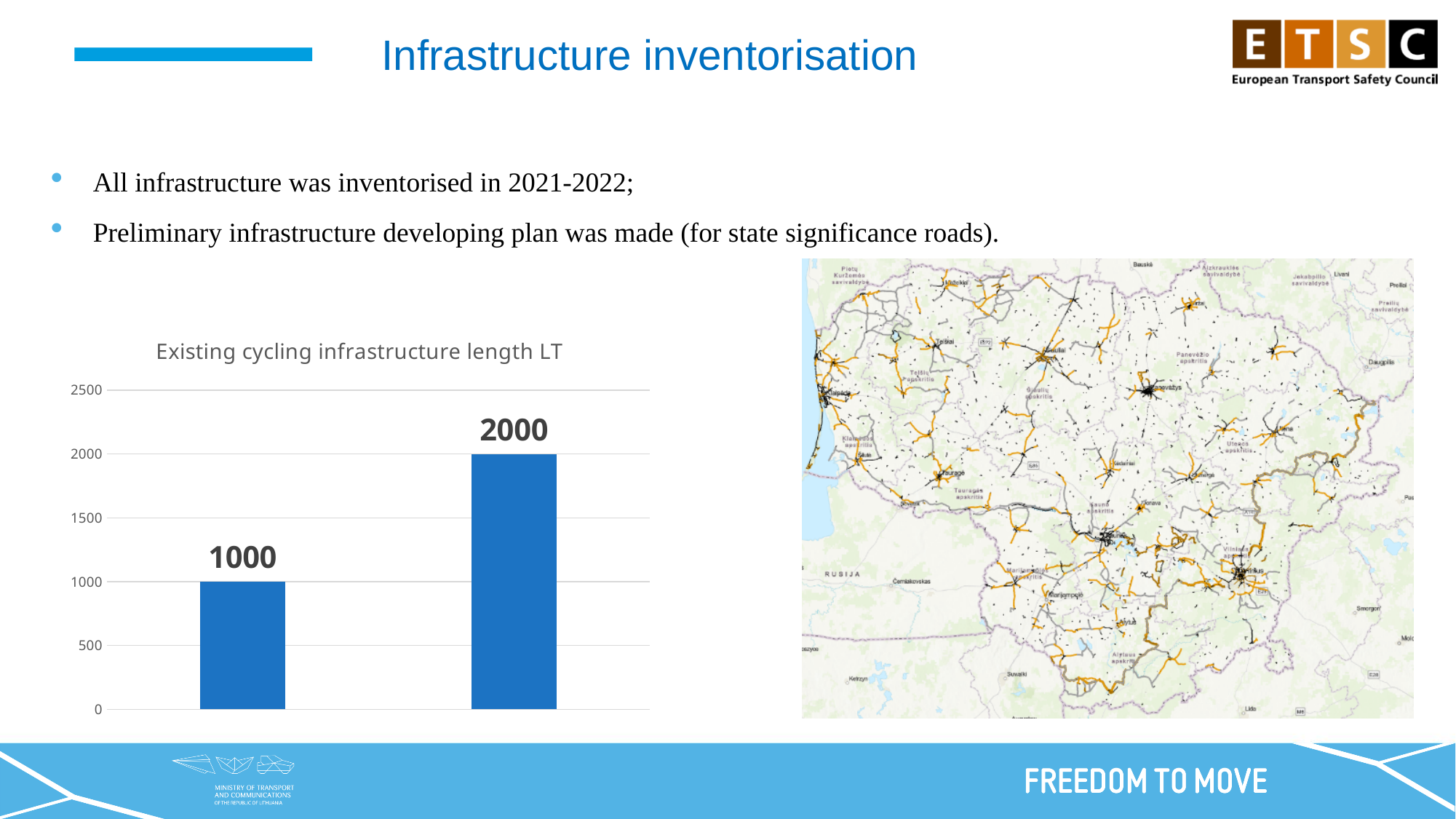
Do the bar values rise or fall from left to right? rise What is the highest value shown on the vertical axis of the chart? 2500 What is the difference between the right bar and the left bar? 1000 Is the value of the left bar greater or less than 1500? less What kind of chart is shown on the slide? bar chart Which bar has the lower value, the left or the right? left What is the title of the chart? Existing cycling infrastructure length LT What is the value of the left bar in the chart? 1000 Which bar has the higher value, the left or the right? right What is the value of the right bar in the chart? 2000 How many bars are plotted in the chart? 2